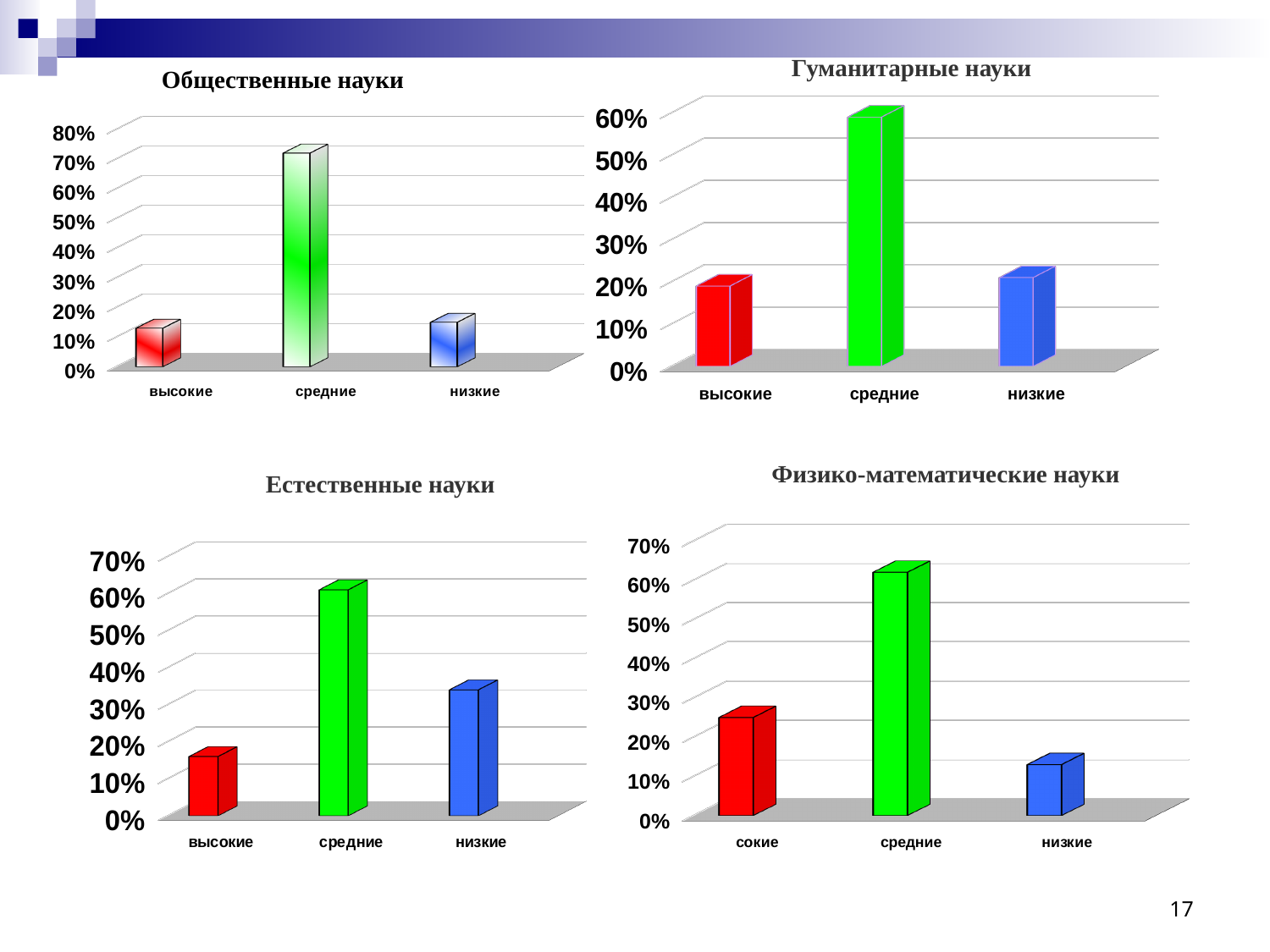
In the chart titled "Естественные науки", is the value for низкие greater or less than 20%? greater In the chart titled "Физико-математические науки", is the value for средние greater or less than 50%? greater In the chart titled "Естественные науки", which is larger, the value for низкие or the value for высокие? низкие In the chart titled "Гуманитарные науки", which category has the highest value? средние In the chart titled "Гуманитарные науки", is the value for средние greater or less than 50%? greater In the chart titled "Естественные науки", which category has the lowest value? высокие How many categories are shown in the chart titled "Гуманитарные науки"? 3 In the chart titled "Общественные науки", which category has the highest value? средние What kind of chart is the chart titled "Естественные науки"? bar chart In the chart titled "Физико-математические науки", which category has the lowest value? низкие